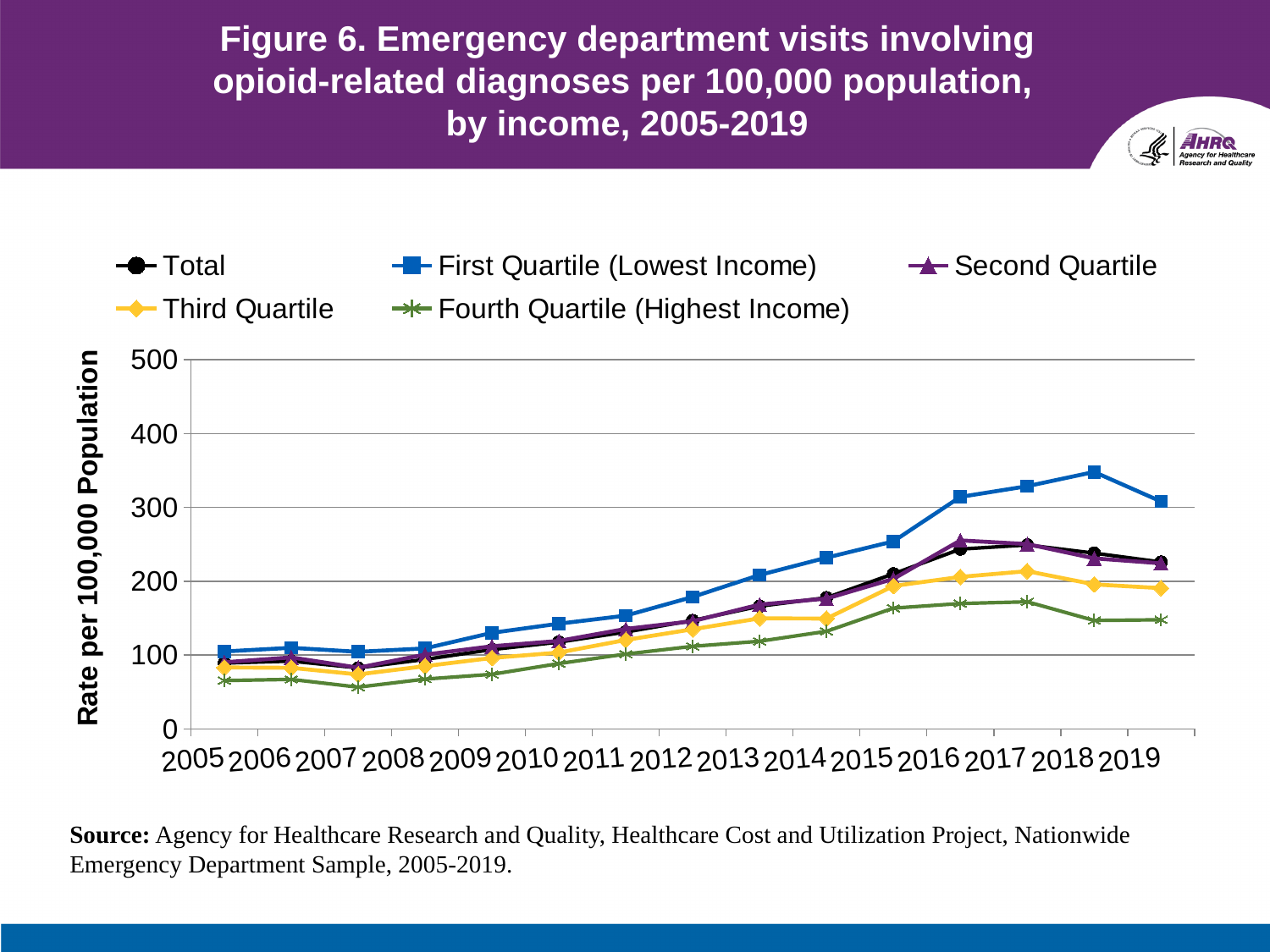
What is the label of the y axis? Rate per 100,000 Population What kind of chart is shown on the slide? Line chart Is the value for First Quartile (Lowest Income) in 2018 greater or less than 300? greater Is the value for Third Quartile in 2019 greater or less than 200? less Which series has the lowest value in 2019? Fourth Quartile (Highest Income) Which series has the highest value in 2019? First Quartile (Lowest Income) In 2017, which is larger: the Second Quartile value or the Third Quartile value? Second Quartile Is the value for Fourth Quartile (Highest Income) in 2005 greater or less than 100? less Does the First Quartile (Lowest Income) series rise or fall from 2005 to 2018? Rise How many years are plotted along the x axis? 15 In which year does the First Quartile (Lowest Income) series reach its highest value? 2018 How many series does the legend list? 5